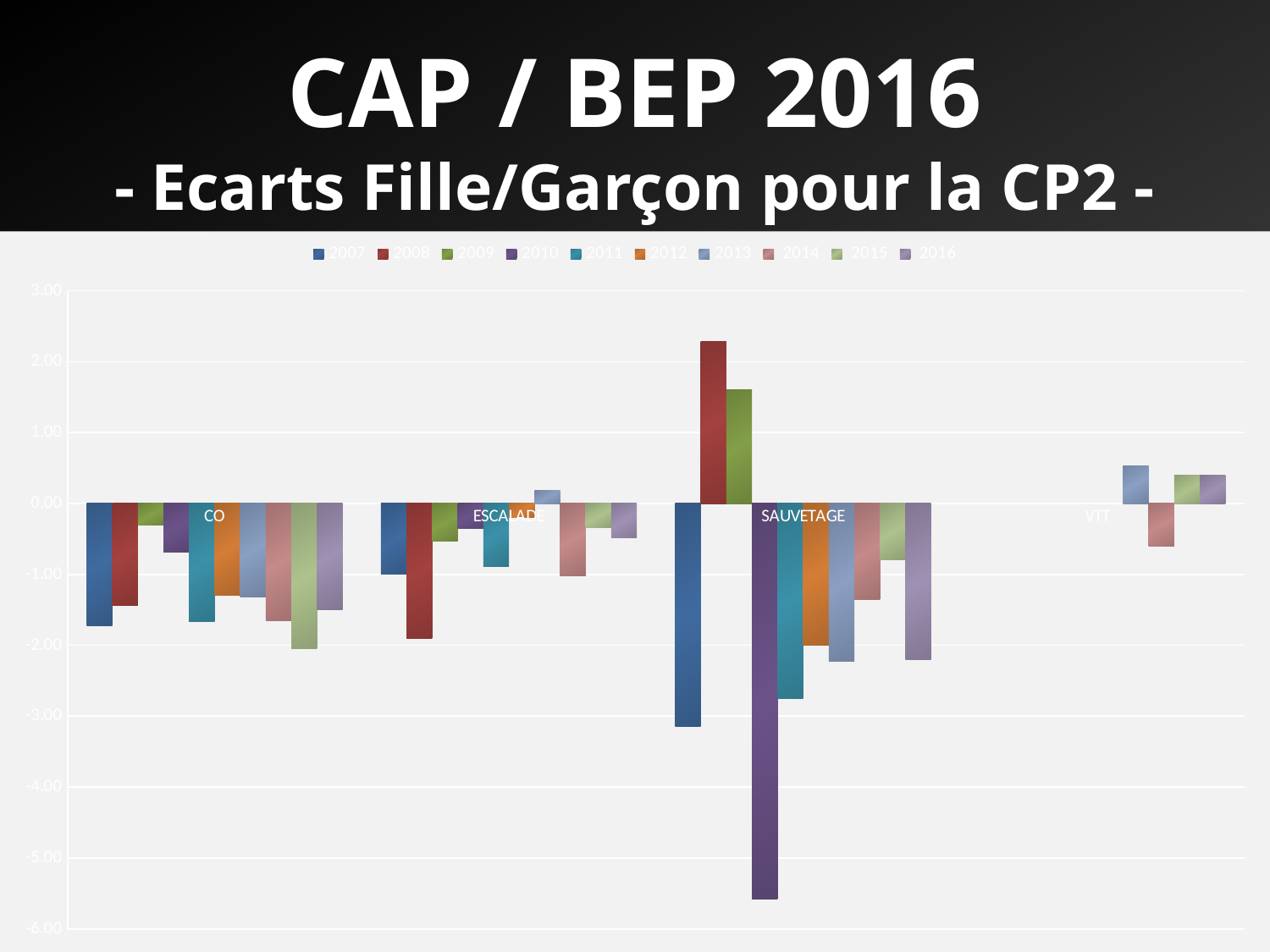
How many series does the legend list? 10 Which category and series has the lowest value in the chart? 2010 in SAUVETAGE Is the value for 2007 in SAUVETAGE greater or less than -2.00? less What is the first series listed in the legend? 2007 Is the value for 2010 in SAUVETAGE greater or less than -5.00? less Which series has the lowest value in the CO category? 2015 How many categories are shown on the x axis of the chart? 4 In the VTT category, which is larger: the value for 2013 or the value for 2014? 2013 What kind of chart is shown on the slide? bar chart Is the value for 2008 in SAUVETAGE greater or less than 2.00? greater Which series has the lowest value in the ESCALADE category? 2008 Which category and series has the highest value in the chart? 2008 in SAUVETAGE